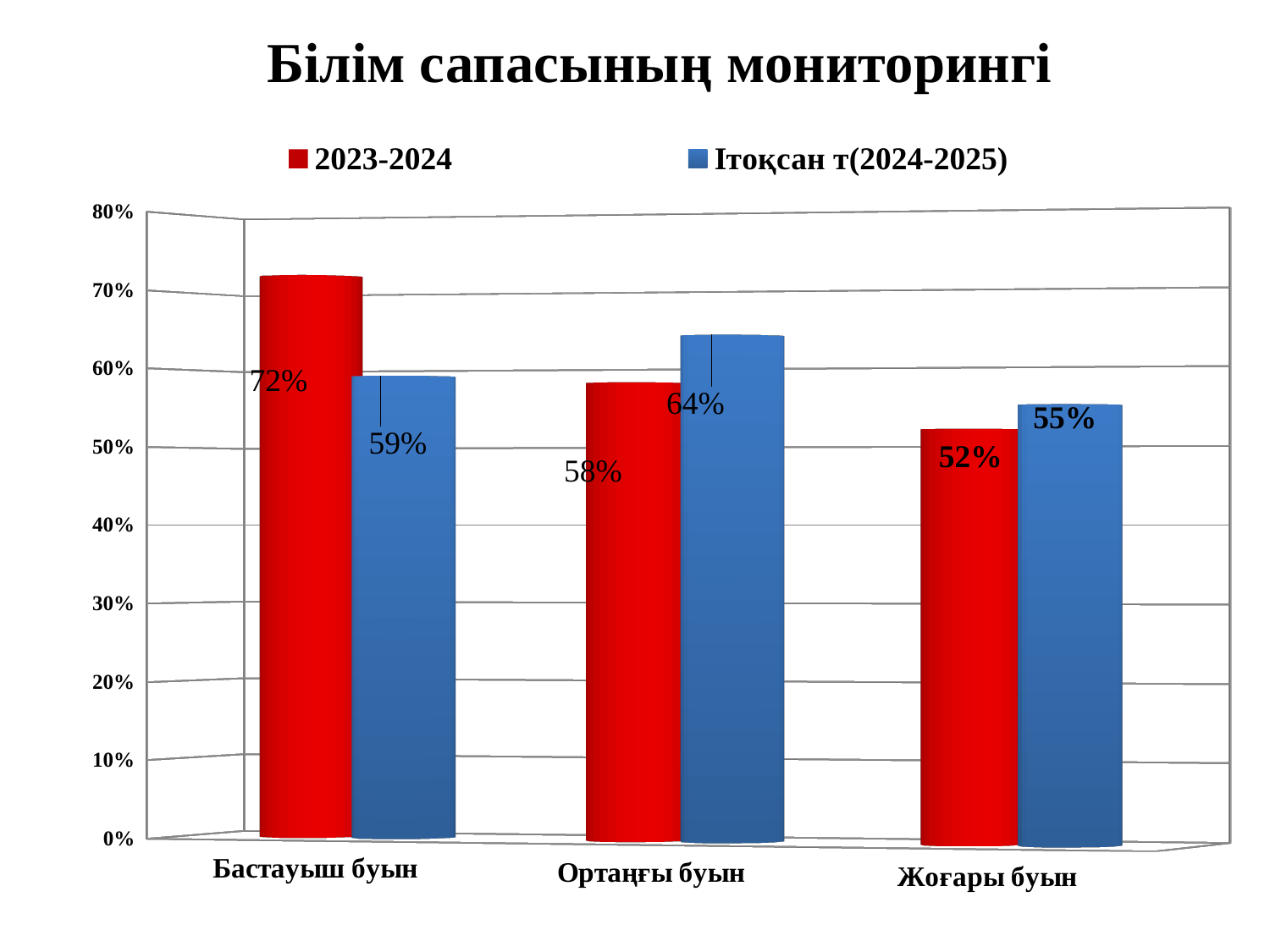
Which category has the highest value in the 2023-2024 series? Бастауыш буын What is the value for Жоғары буын in the 2023-2024 series? 52% What is the value for Бастауыш буын in the 2023-2024 series? 72% Which category has the lowest value in the Ітоқсан т(2024-2025) series? Жоғары буын How many categories are shown on the x axis? 3 What kind of chart is shown on the slide? Bar chart What is the value for Ортаңғы буын in the Ітоқсан т(2024-2025) series? 64% Which is larger for Ортаңғы буын: the 2023-2024 value or the Ітоқсан т(2024-2025) value? Ітоқсан т(2024-2025) What is the value for Бастауыш буын in the Ітоқсан т(2024-2025) series? 59% What is the difference between the 2023-2024 and Ітоқсан т(2024-2025) values for Бастауыш буын? 13% What is the title of the chart? Білім сапасының мониторингі How many series does the legend list? 2